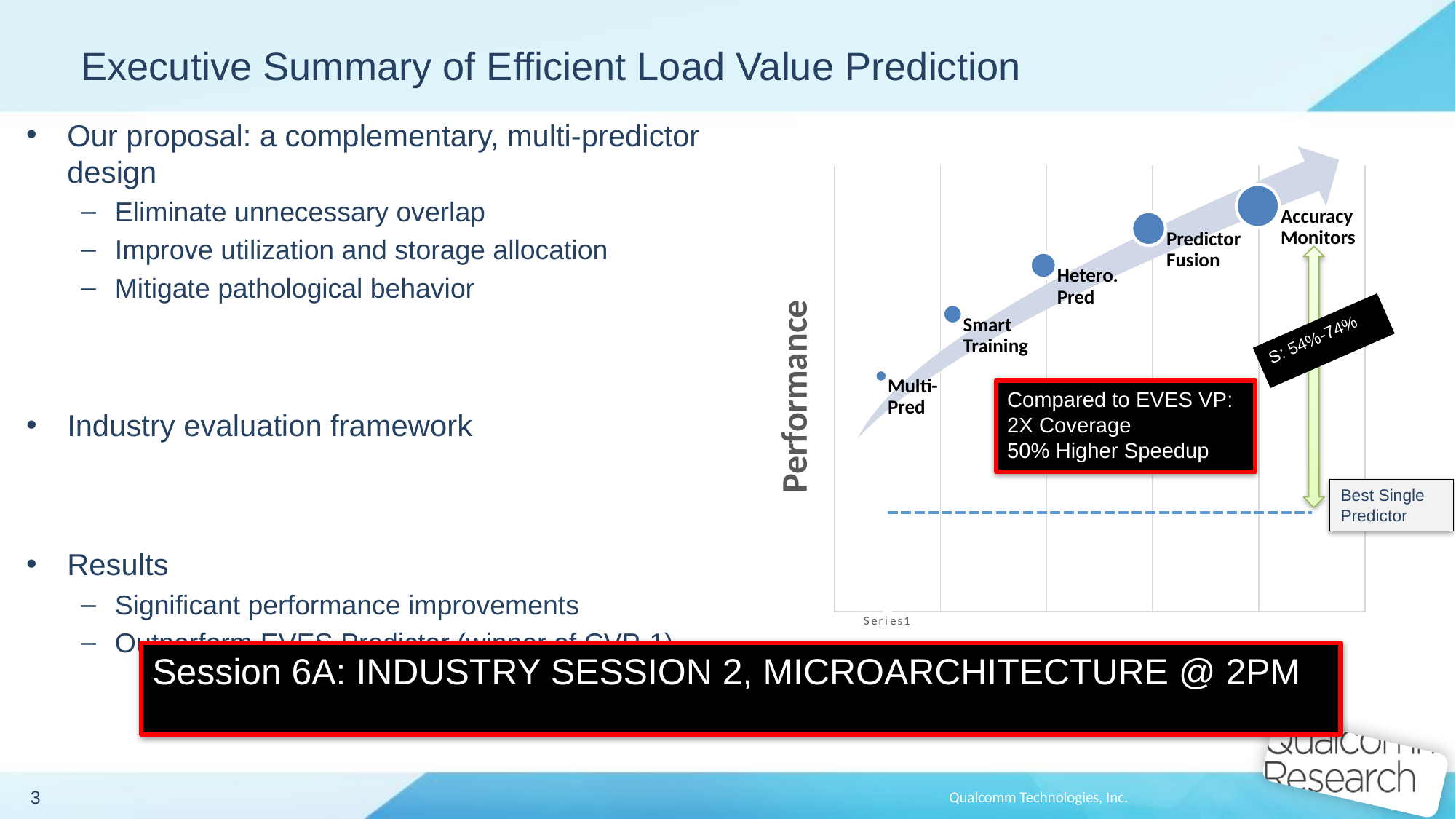
What is the label on the vertical axis of the chart? Performance Which labeled point on the chart has the lowest performance? Multi-Pred How many labeled data points are plotted on the chart? 5 Which labeled point lies immediately to the left of Accuracy Monitors on the chart? Predictor Fusion What does the dashed horizontal line on the chart represent? Best Single Predictor Which labeled point lies immediately to the right of Smart Training on the chart? Hetero. Pred What kind of chart is shown on the slide? scatter chart Which has higher performance on the chart, Predictor Fusion or Smart Training? Predictor Fusion Which labeled point on the chart has the highest performance? Accuracy Monitors Do the plotted points rise or fall from left to right along the x axis? rise Which has higher performance on the chart, Hetero. Pred or Multi-Pred? Hetero. Pred